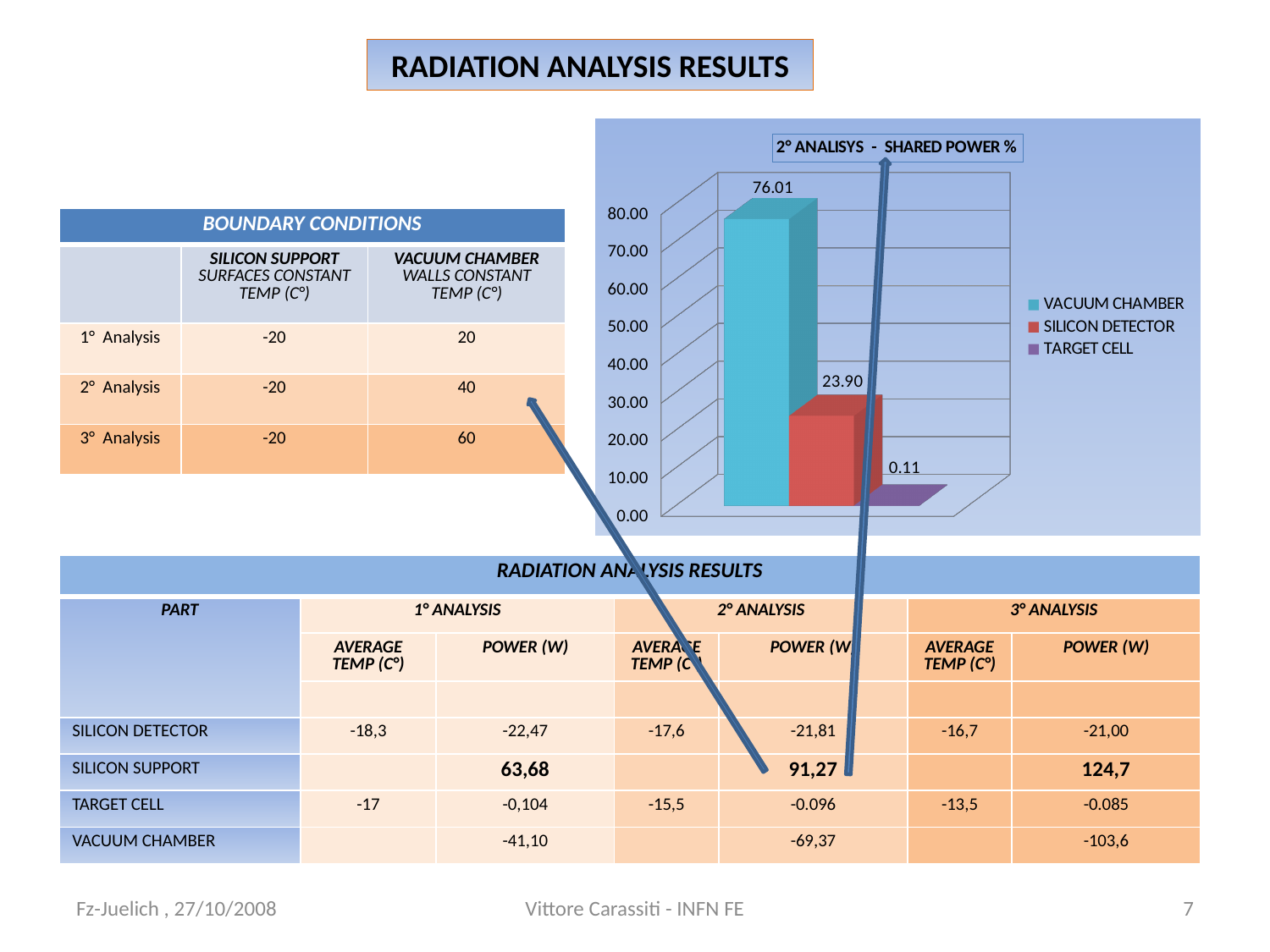
Is the value for SILICON DETECTOR greater or less than 30.00? less What is the value for VACUUM CHAMBER in the chart? 76.01 How many bars are plotted in the chart? 3 How many entries does the chart legend list? 3 Which category has the highest value in the chart? VACUUM CHAMBER What is the value for SILICON DETECTOR in the chart? 23.90 Which category has the lowest value in the chart? TARGET CELL What is the title of the chart? 2° ANALISYS - SHARED POWER % What is the value for TARGET CELL in the chart? 0.11 Is the value for VACUUM CHAMBER greater or less than 70.00? greater What is the difference between the VACUUM CHAMBER and SILICON DETECTOR values? 52.11 Which is larger, the value for SILICON DETECTOR or the value for TARGET CELL? SILICON DETECTOR